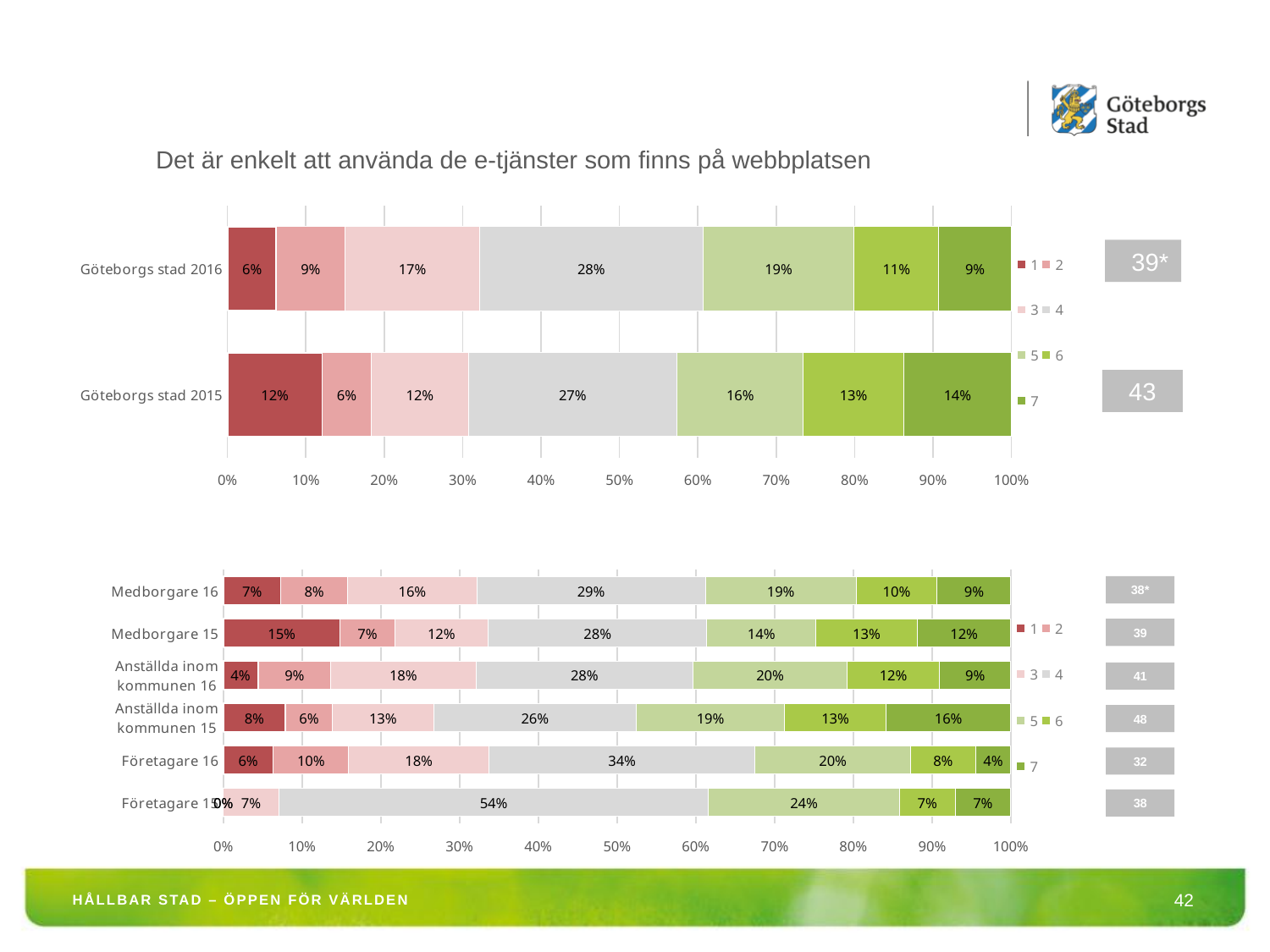
In the top chart, which has the larger value for series 1: Göteborgs stad 2016 or Göteborgs stad 2015? Göteborgs stad 2015 In the top chart, what is the value of series 4 for Göteborgs stad 2016? 28% In the bottom chart, what is the value of series 4 for Företagare 16? 34% In the top chart, what is the value of series 7 for Göteborgs stad 2015? 14% In the bottom chart, which category has the largest series 4 segment? Företagare 15 In the top chart, what is the difference between the series 7 values for Göteborgs stad 2015 and Göteborgs stad 2016? 5 percentage points What kind of chart is the top chart? Stacked bar chart In the bottom chart, how many categories are shown? 6 In the bottom chart, what is the value of series 1 for Medborgare 15? 15% What is the title shown above the charts on the slide? Det är enkelt att använda de e-tjänster som finns på webbplatsen In the bottom chart, what is the value of series 5 for Anställda inom kommunen 16? 20% In the top chart, how many series does the legend list? 7